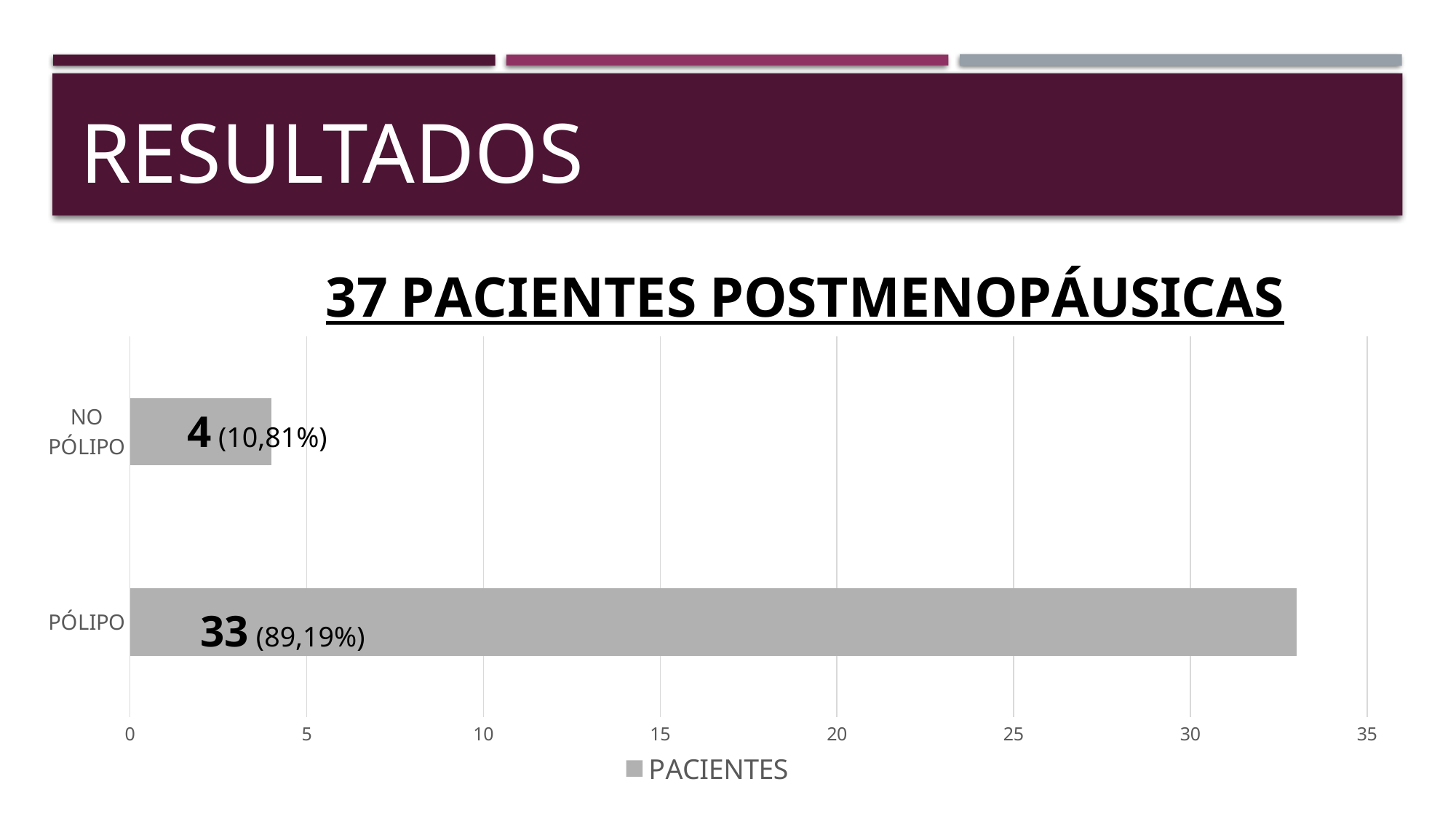
What is the difference between the values for PÓLIPO and NO PÓLIPO? 29 What is the value for PÓLIPO? 33 What is the title of the chart? 37 PACIENTES POSTMENOPÁUSICAS Is the value for PÓLIPO greater or less than 30? greater Which category has the highest value? PÓLIPO Which is larger, the value for PÓLIPO or NO PÓLIPO? PÓLIPO How many categories are shown in the chart? 2 What is the value for NO PÓLIPO? 4 Which category has the lowest value? NO PÓLIPO What percentage is shown next to the PÓLIPO bar? 89,19% What percentage is shown next to the NO PÓLIPO bar? 10,81% What kind of chart is shown on the slide? bar chart